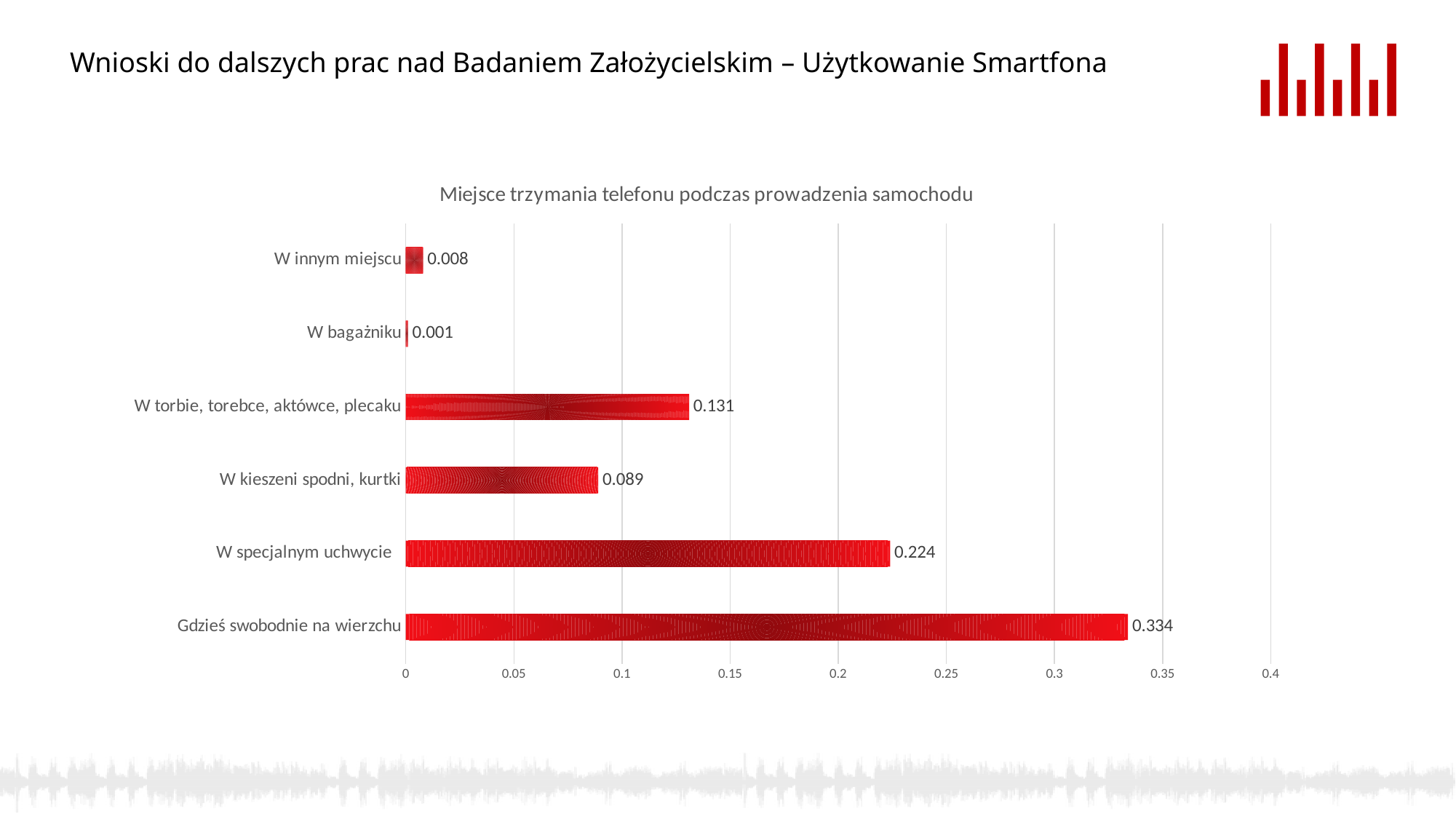
What kind of chart is shown on the slide? Bar chart What is the value for "W bagażniku"? 0.001 What is the value for "W kieszeni spodni, kurtki"? 0.089 What is the difference between the values for "Gdzieś swobodnie na wierzchu" and "W specjalnym uchwycie"? 0.110 How many categories are shown in the chart? 6 What is the title of the chart? Miejsce trzymania telefonu podczas prowadzenia samochodu Which category has the lowest value? W bagażniku What is the value for "W specjalnym uchwycie"? 0.224 Is the value for "W specjalnym uchwycie" greater or less than 0.2? greater What is the value for "Gdzieś swobodnie na wierzchu"? 0.334 Which category has the highest value? Gdzieś swobodnie na wierzchu Which is larger: the value for "W torbie, torebce, aktówce, plecaku" or "W kieszeni spodni, kurtki"? W torbie, torebce, aktówce, plecaku